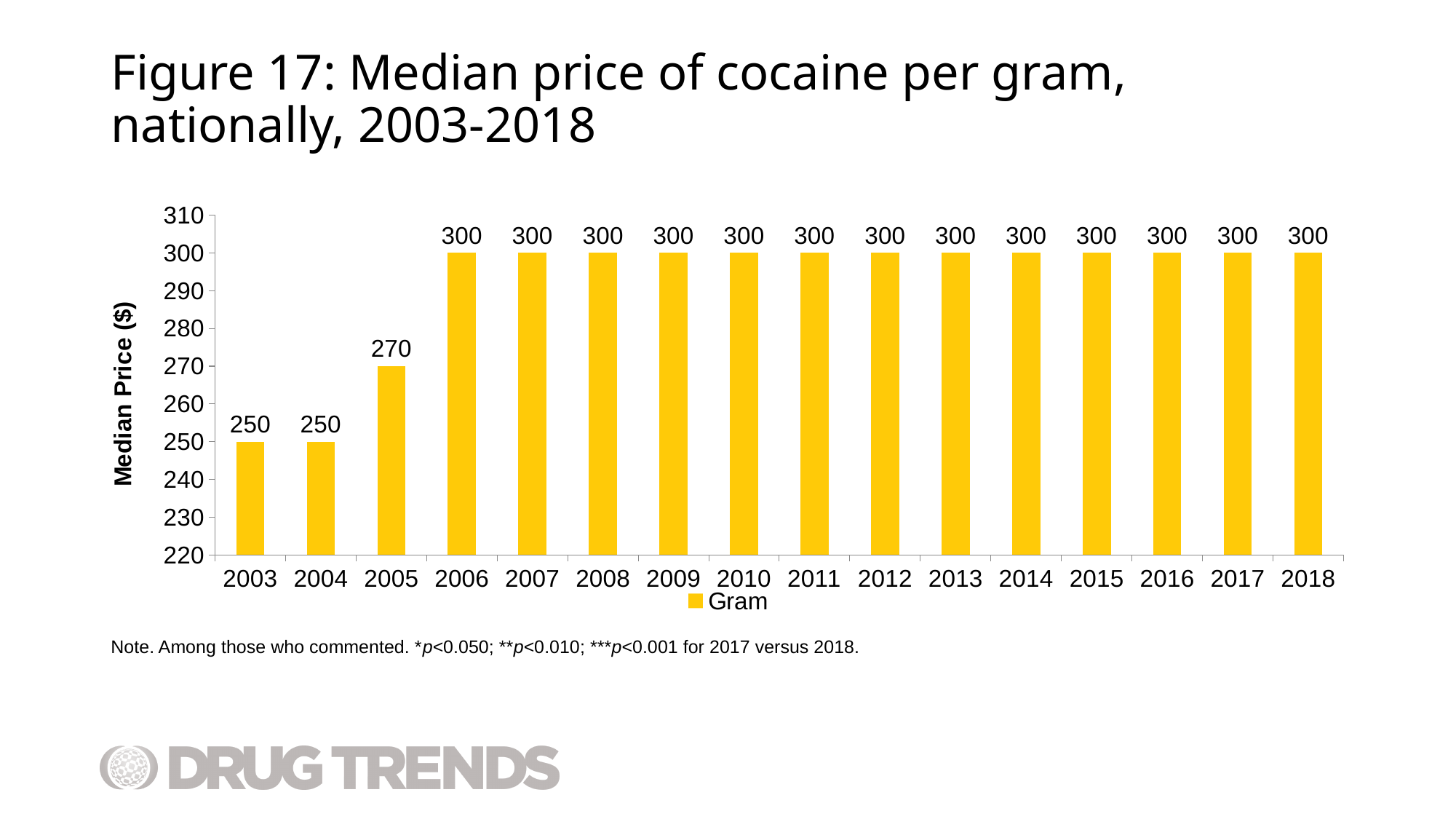
How many series does the legend list? 1 How many years are shown on the x axis? 16 What is the median price of cocaine per gram in 2018? 300 Does the median price rise or fall from 2003 to 2006? rise What kind of chart is shown? bar chart Which year has the lowest median price shown, 2004 or 2005? 2004 What is the difference between the median price in 2006 and in 2003? 50 Is the median price in 2005 greater or less than 260? greater Is the median price in 2004 greater or less than 270? less What is the median price of cocaine per gram in 2003? 250 What is the difference between the median price in 2005 and in 2004? 20 What is the median price of cocaine per gram in 2005? 270